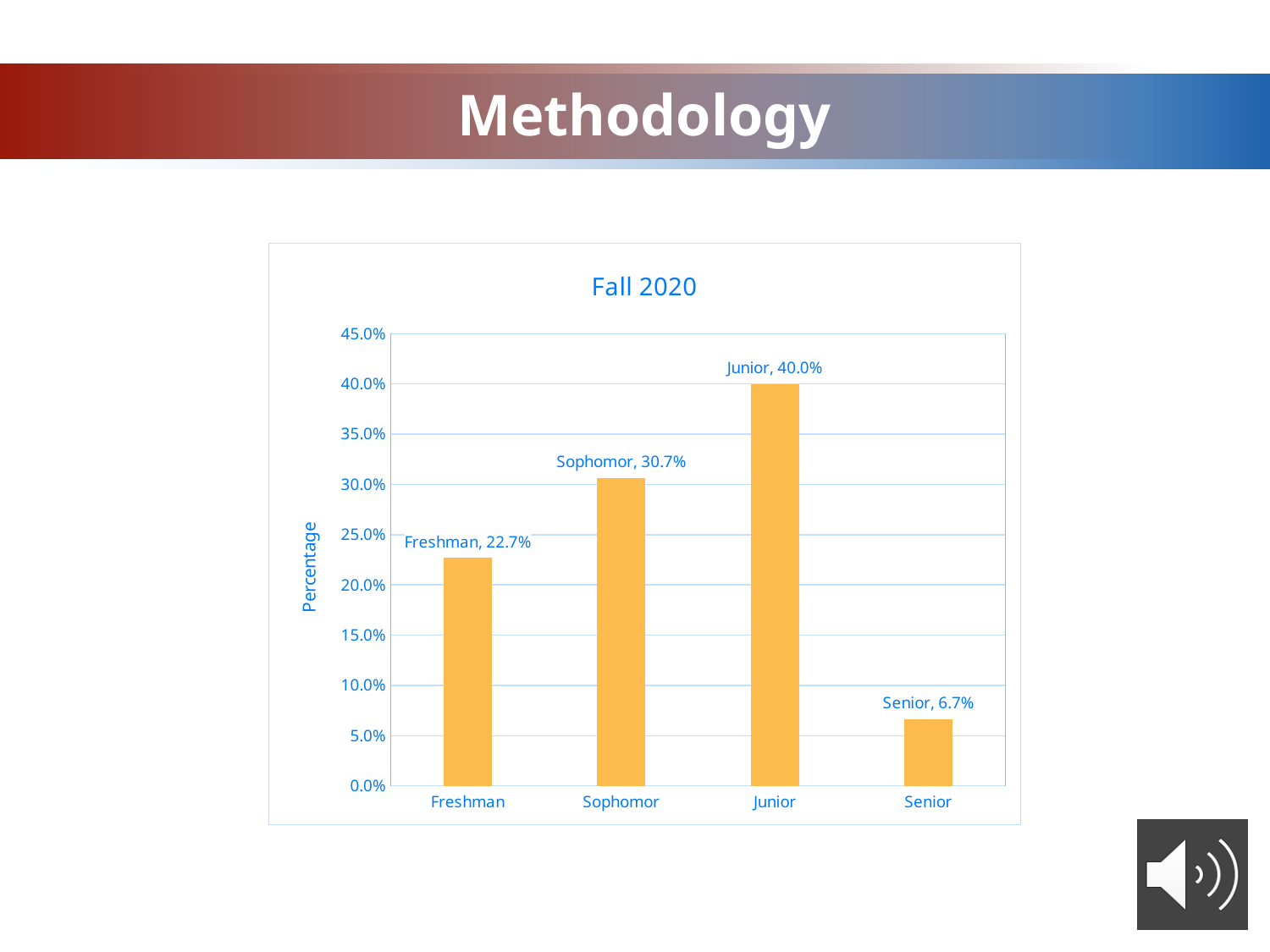
What kind of chart is shown? bar chart What is the difference between the values for Junior and Sophomor? 9.3% What is the value for Senior? 6.7% Which category has the lowest value? Senior Is the value for Senior greater or less than 10.0%? less How many categories are shown on the x axis? 4 What is the title of the chart? Fall 2020 What is the value for Freshman? 22.7% Which category has the highest value? Junior Which is larger, the value for Freshman or the value for Sophomor? Sophomor What is the label of the y axis? Percentage What is the value for Junior? 40.0%